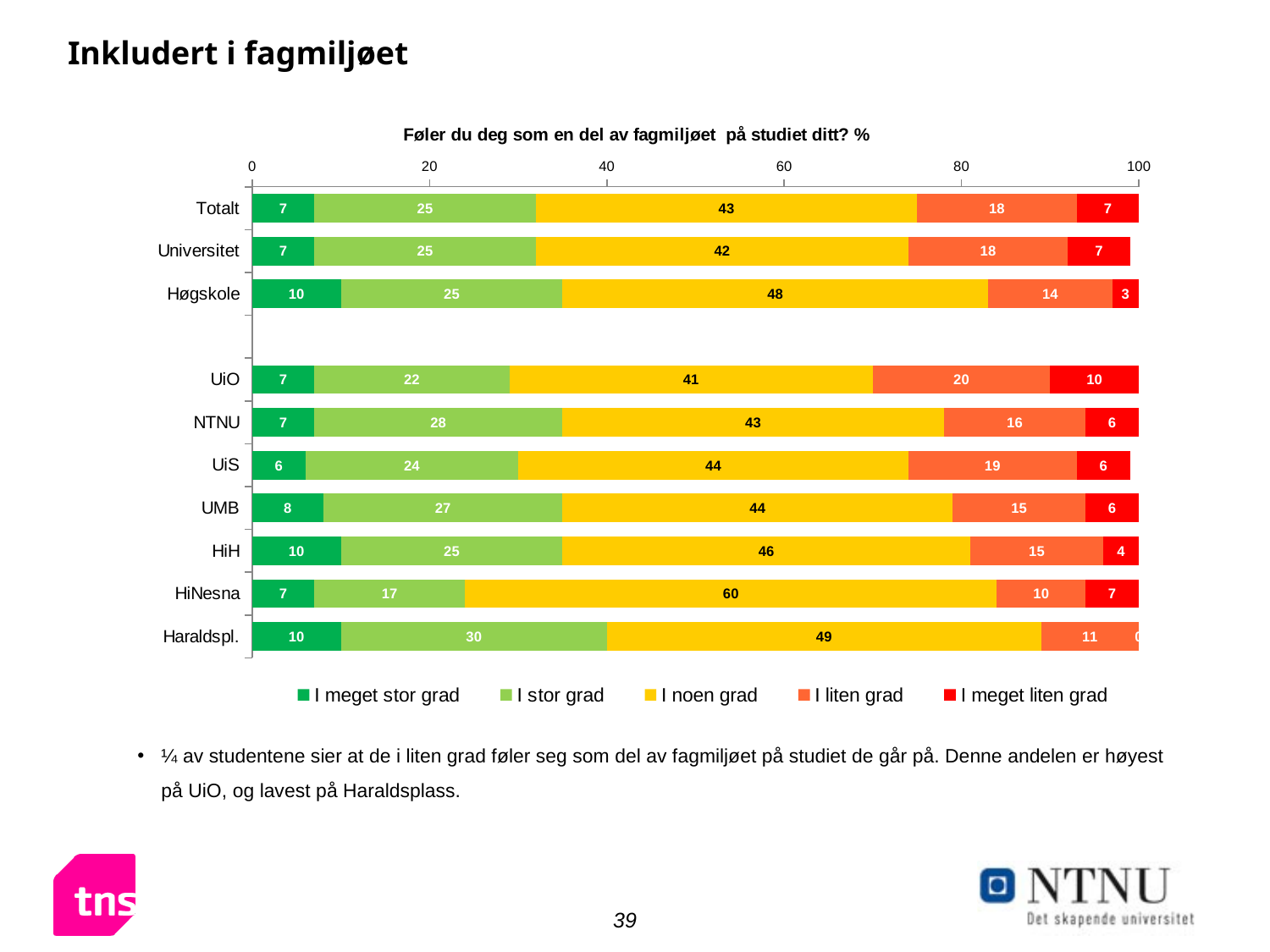
Which category has the lowest value for "I meget liten grad"? Haraldspl. Which is larger: the "I liten grad" value for UiO or for NTNU? UiO Which category has the highest value for "I noen grad"? HiNesna How many categories are shown on the y axis? 10 What is the value for "I stor grad" for Haraldspl.? 30 What is the title of the chart? Føler du deg som en del av fagmiljøet på studiet ditt? % What is the value for "I meget liten grad" for UiO? 10 What is the value for "I liten grad" for Totalt? 18 What is the value for "I noen grad" for HiNesna? 60 What is the difference between the "I noen grad" values for HiNesna and UiO? 19 What kind of chart is shown on the slide? Stacked bar chart How many series does the legend list? 5